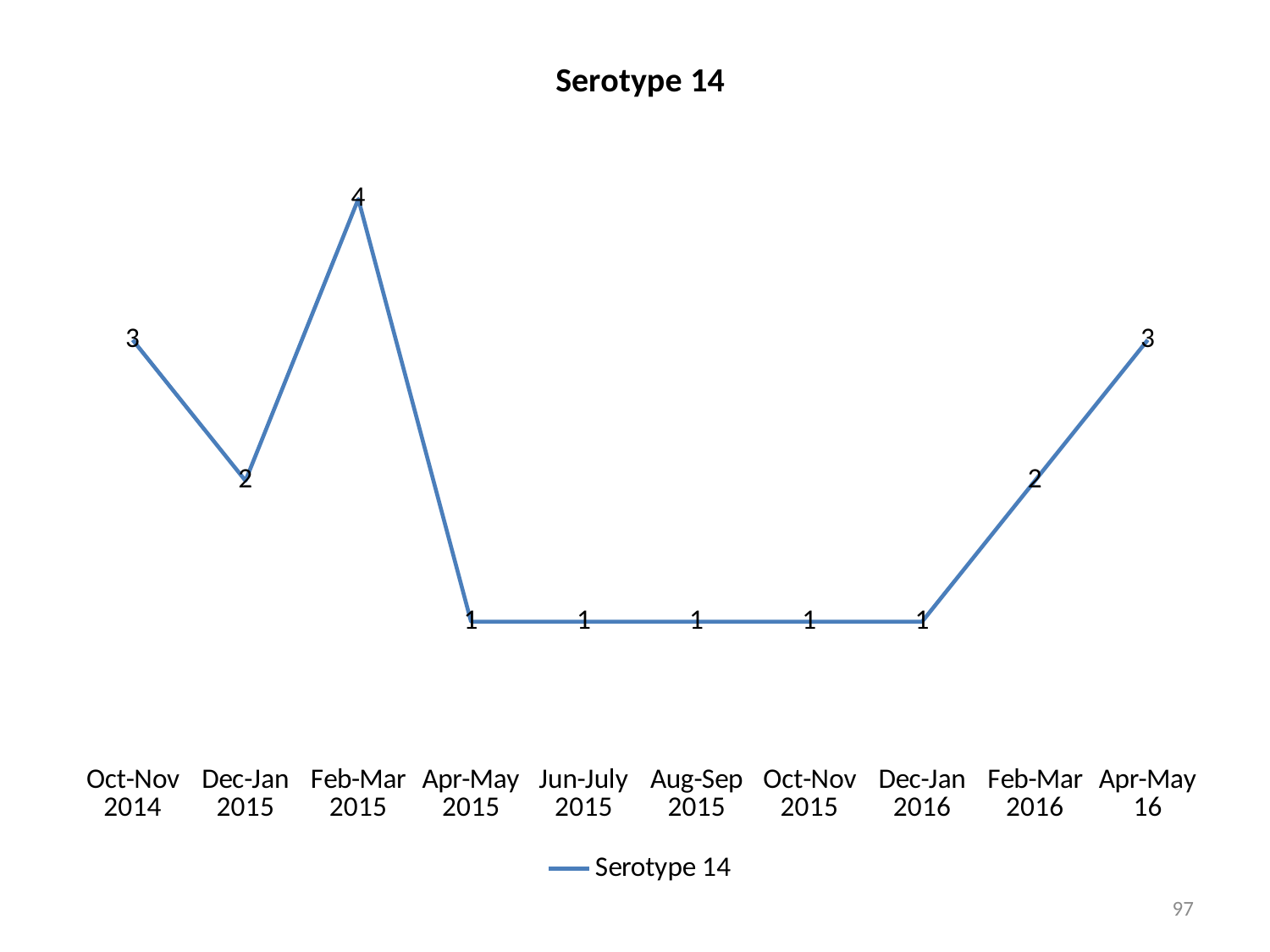
How many periods are plotted on the x axis? 10 What is the difference between the values for Feb-Mar 2015 and Dec-Jan 2015? 2 What is the value for Feb-Mar 2015? 4 Which is larger, the value for Oct-Nov 2014 or the value for Dec-Jan 2015? Oct-Nov 2014 What is the title of the chart? Serotype 14 What is the value for Feb-Mar 2016? 2 What kind of chart is shown? Line chart Which period has the highest value? Feb-Mar 2015 How many series does the legend list? 1 What is the value for Aug-Sep 2015? 1 What is the value for Oct-Nov 2014? 3 What is the difference between the values for Apr-May 16 and Feb-Mar 2016? 1